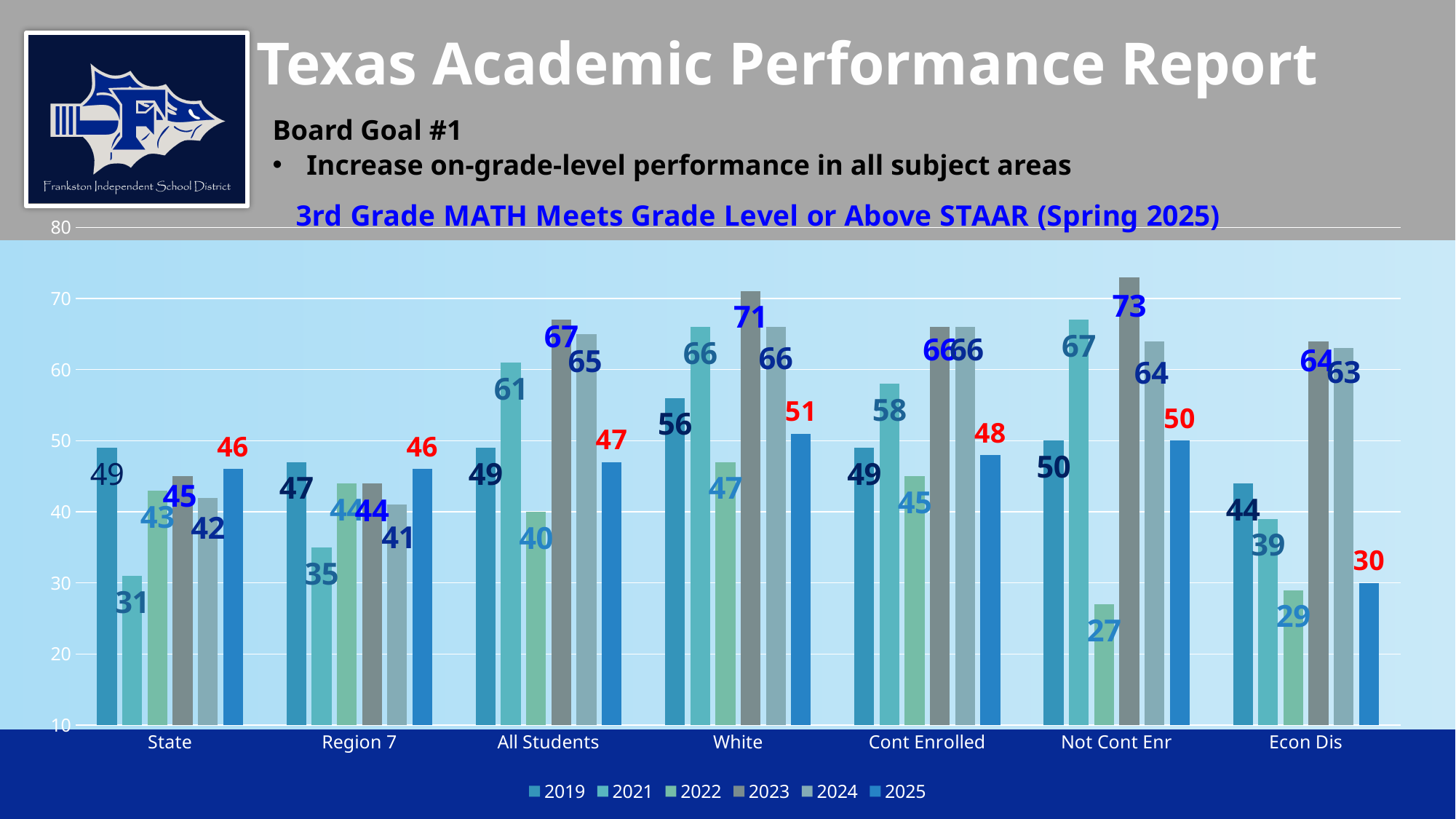
What is the title of the chart? 3rd Grade MATH Meets Grade Level or Above STAAR (Spring 2025) Which category has the highest 2025 value? White What is the 2022 value for Econ Dis? 29 What is the 2021 value for State? 31 Which category has the lowest 2022 value? Not Cont Enr How many categories are shown on the x axis? 7 What is the difference between the 2023 and 2025 values for White? 20 What kind of chart is shown on the slide? bar chart Which is larger, the 2019 value for Region 7 or the 2019 value for Econ Dis? Region 7 What is the 2023 value for Not Cont Enr? 73 How many series does the legend list? 6 What is the 2025 value for All Students? 47